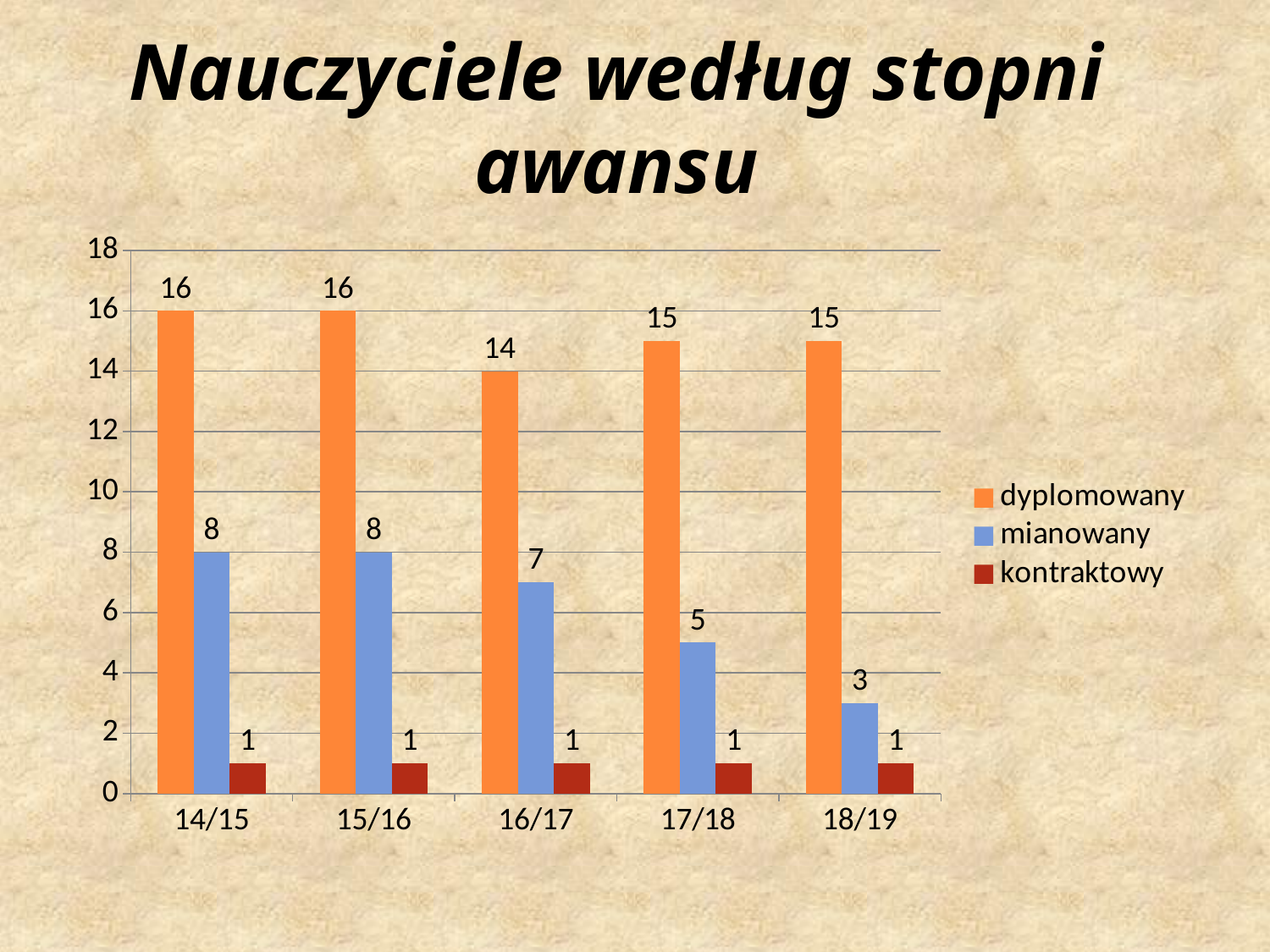
What is the difference between the dyplomowany and mianowany values in 18/19? 12 What is the value for mianowany in 17/18? 5 What is the total of the three values in 17/18? 21 Does the mianowany series rise or fall from 14/15 to 18/19? fall In which year is the mianowany value lowest? 18/19 Which is larger in 16/17: the dyplomowany value or the mianowany value? dyplomowany What kind of chart is shown on the slide? bar chart What is the value for kontraktowy in 18/19? 1 What is the title of the chart? Nauczyciele według stopni awansu How many years are shown on the x axis? 5 What is the value for dyplomowany in 16/17? 14 How many series does the legend list? 3